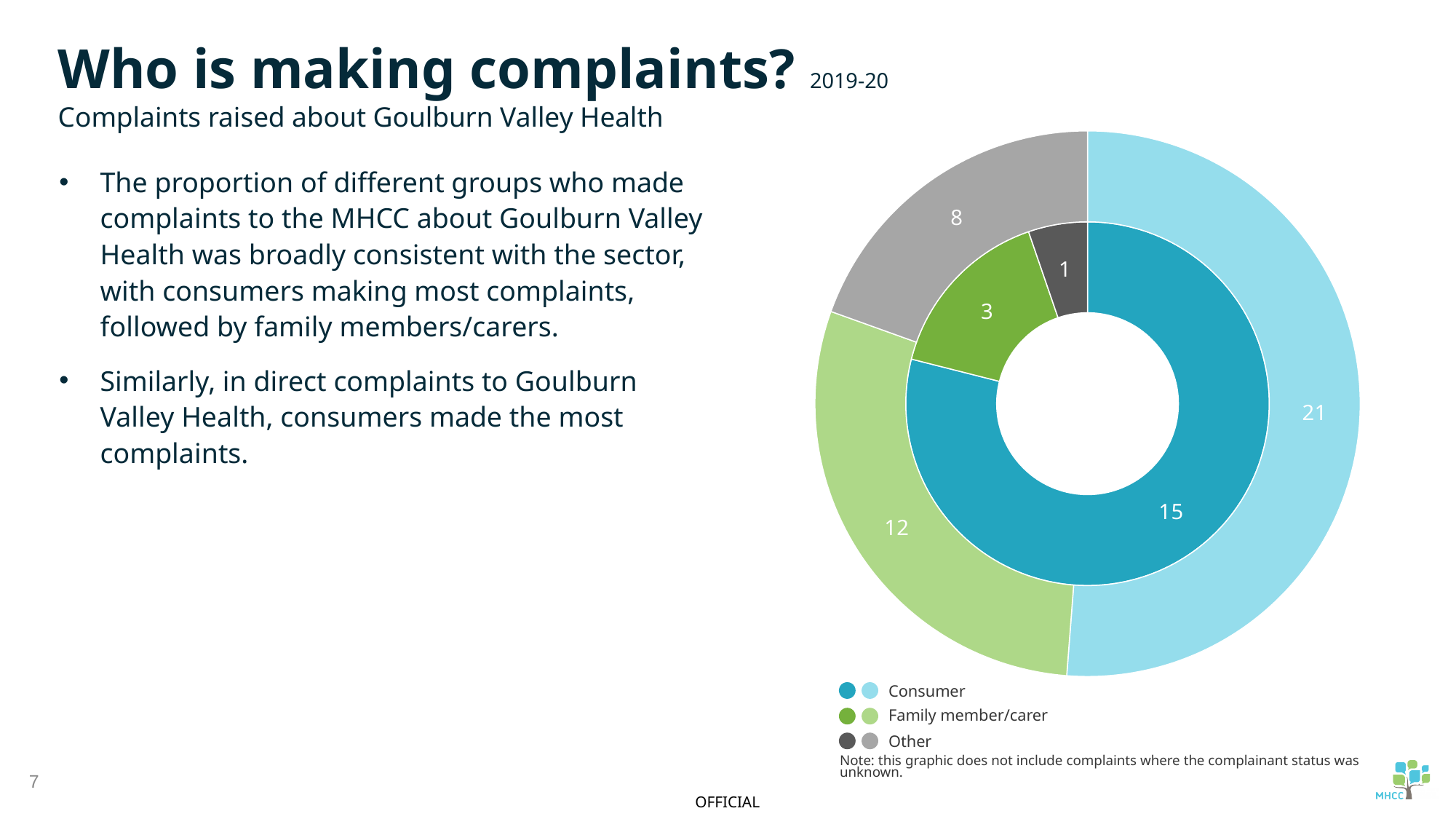
What kind of chart is shown on the slide? doughnut chart What is the total of the values shown in the outer ring of the chart? 41 What is the value for Family member/carer in the outer ring of the chart? 12 How many categories does the chart's legend list? 3 What is the value for Consumer in the inner ring of the chart? 15 What is the value for Consumer in the outer ring of the chart? 21 Which colour does the legend use for the Consumer category? blue What is the value for Other in the inner ring of the chart? 1 In the inner ring, which is larger: Family member/carer or Other? Family member/carer In the outer ring, how much larger is the Consumer value than the Family member/carer value? 9 Which category has the largest value in the outer ring of the chart? Consumer Which category has the smallest value in the inner ring of the chart? Other